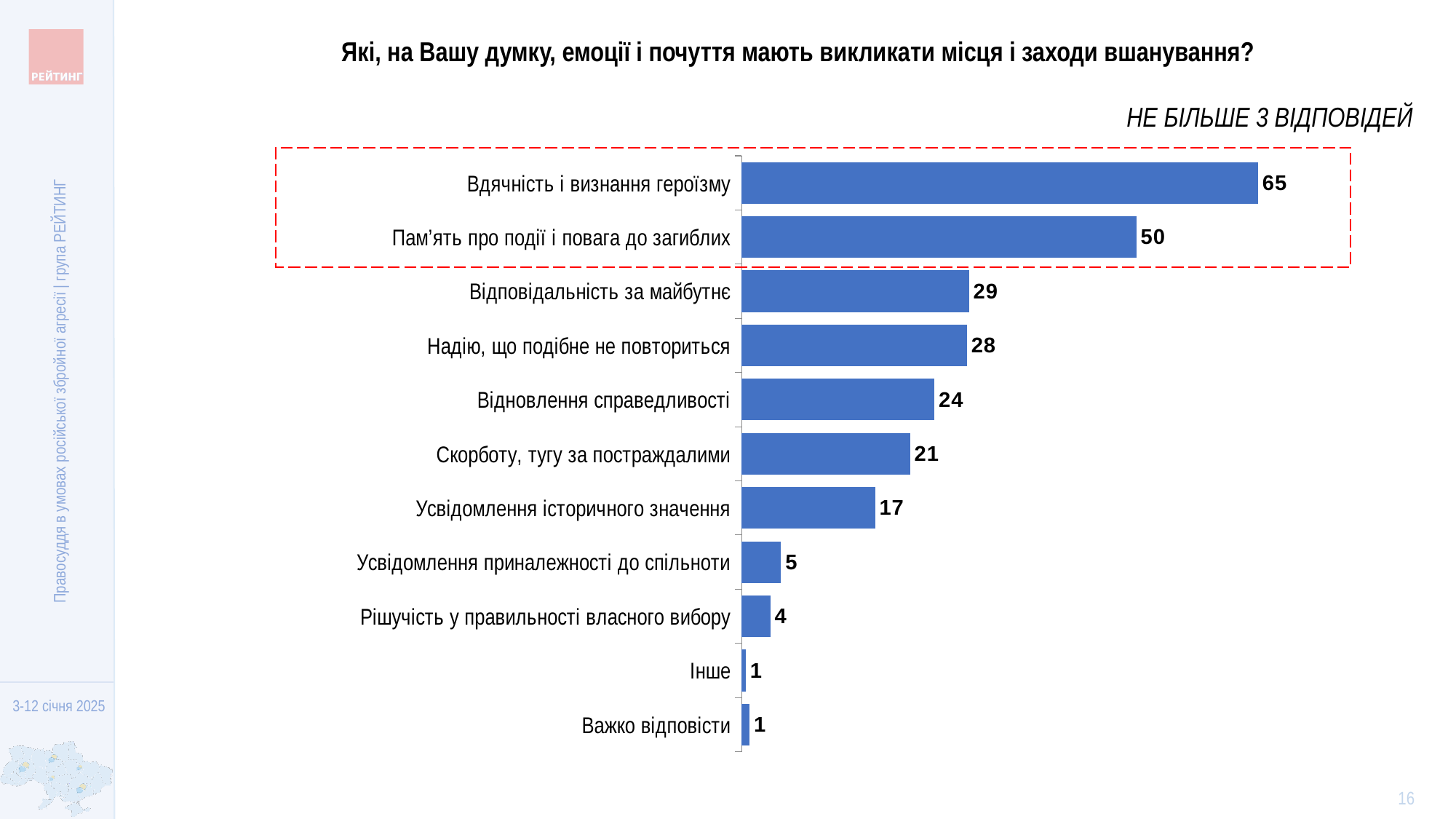
What kind of chart is shown on the slide? Bar chart How many categories are enclosed in the red dashed box? 2 Which is larger: the value for "Усвідомлення приналежності до спільноти" or the value for "Рішучість у правильності власного вибору"? Усвідомлення приналежності до спільноти Which is larger: the value for "Надію, що подібне не повториться" or the value for "Відновлення справедливості"? Надію, що подібне не повториться Which category has the highest value? Вдячність і визнання героїзму What value is shown for "Відновлення справедливості"? 24 How many categories are shown in the chart? 11 What is the difference between the values for "Відповідальність за майбутнє" and "Скорботу, тугу за постраждалими"? 8 What value is shown for "Вдячність і визнання героїзму"? 65 What is the difference between the values for "Вдячність і визнання героїзму" and "Пам'ять про події і повага до загиблих"? 15 What value is shown for "Інше"? 1 What value is shown for "Усвідомлення історичного значення"? 17